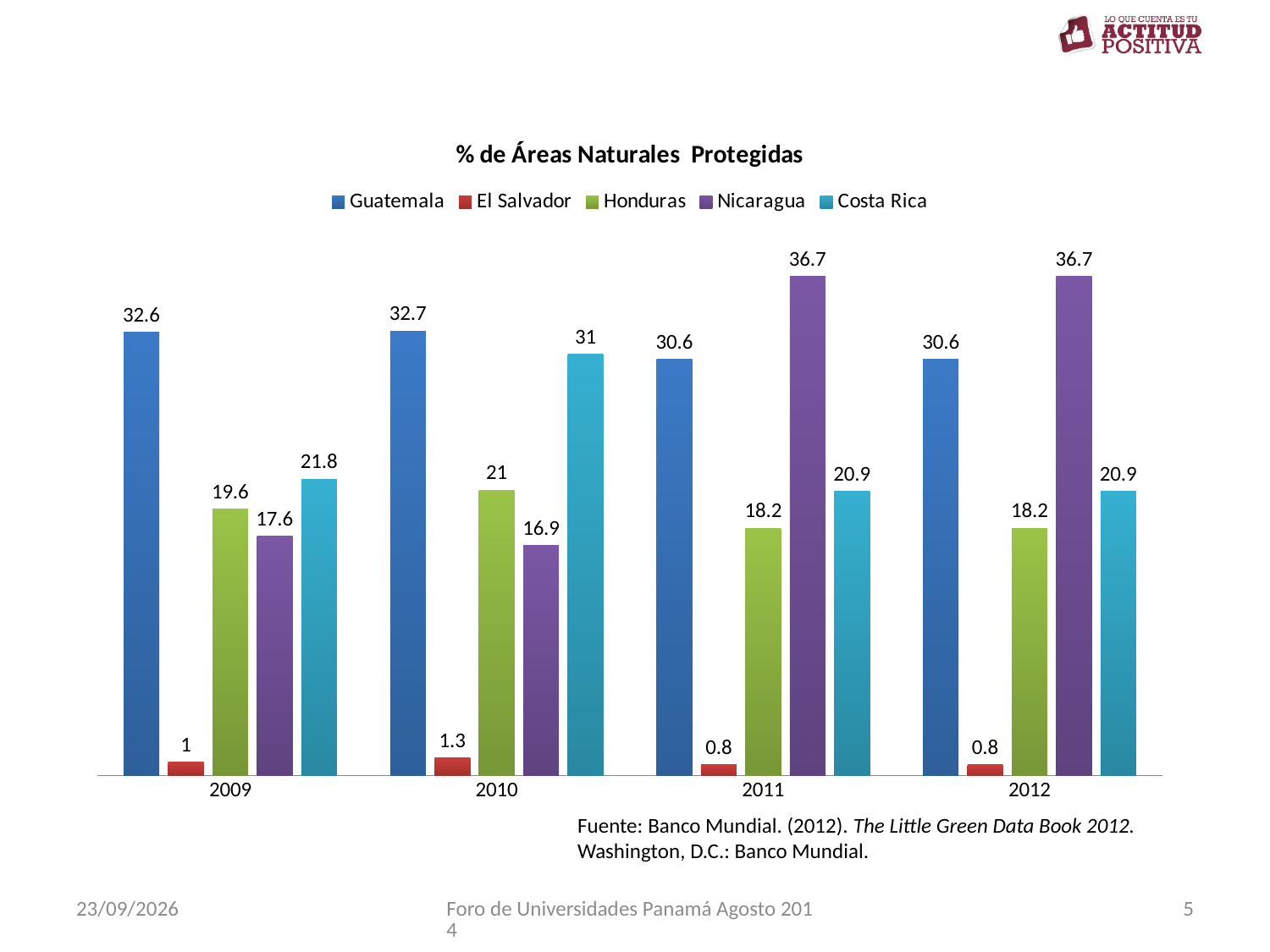
What is the value for Guatemala in 2009? 32.6 Which is larger in 2009, Honduras or Nicaragua? Honduras Which country has the lowest value in 2009? El Salvador What is the value for El Salvador in 2010? 1.3 How many series does the legend list? 5 What is the title of the chart? % de Áreas Naturales Protegidas What kind of chart is shown on the slide? Bar chart What is the value for Nicaragua in 2012? 36.7 What is the difference between Guatemala and Honduras in 2010? 11.7 Which country has the highest value in 2011? Nicaragua What is the value for Costa Rica in 2010? 31 How many years are shown on the x axis? 4